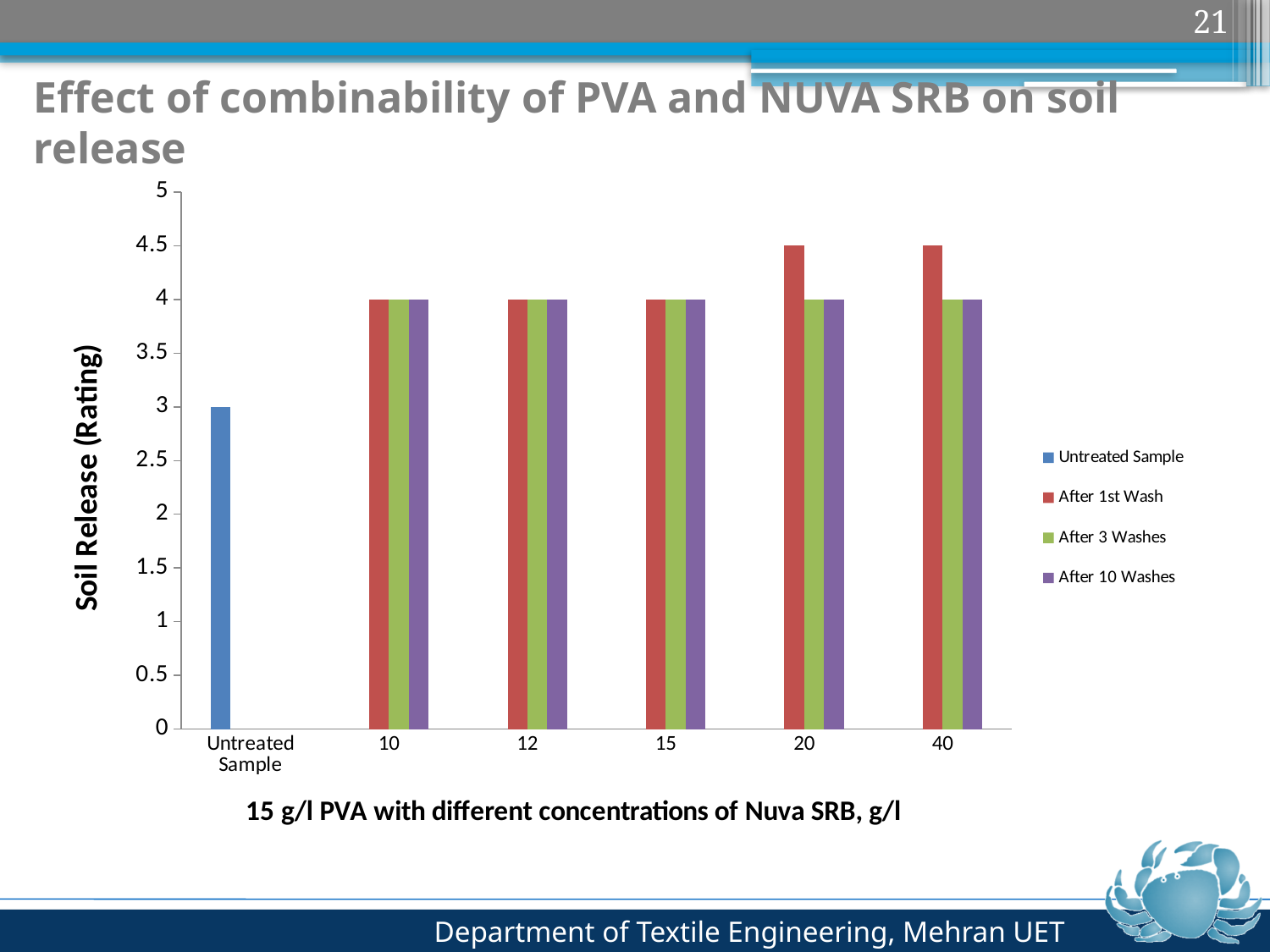
Which is larger: the After 1st Wash rating at 40 g/l or the After 1st Wash rating at 15 g/l? After 1st Wash at 40 g/l What is the difference between the After 1st Wash rating at 20 g/l and the After 3 Washes rating at 20 g/l? 0.5 How many categories are shown on the x axis? 6 What is the difference between the After 1st Wash rating at 10 g/l and the Untreated Sample rating? 1 What kind of chart is shown on the slide? bar chart What is the soil release rating After 3 Washes at 12 g/l Nuva SRB? 4 What is the label of the y axis? Soil Release (Rating) What is the soil release rating for the Untreated Sample? 3 Is the soil release rating for the Untreated Sample greater or less than 4? less What is the soil release rating After 1st Wash at 20 g/l Nuva SRB? 4.5 What is the soil release rating After 10 Washes at 40 g/l Nuva SRB? 4 How many series does the legend list? 4